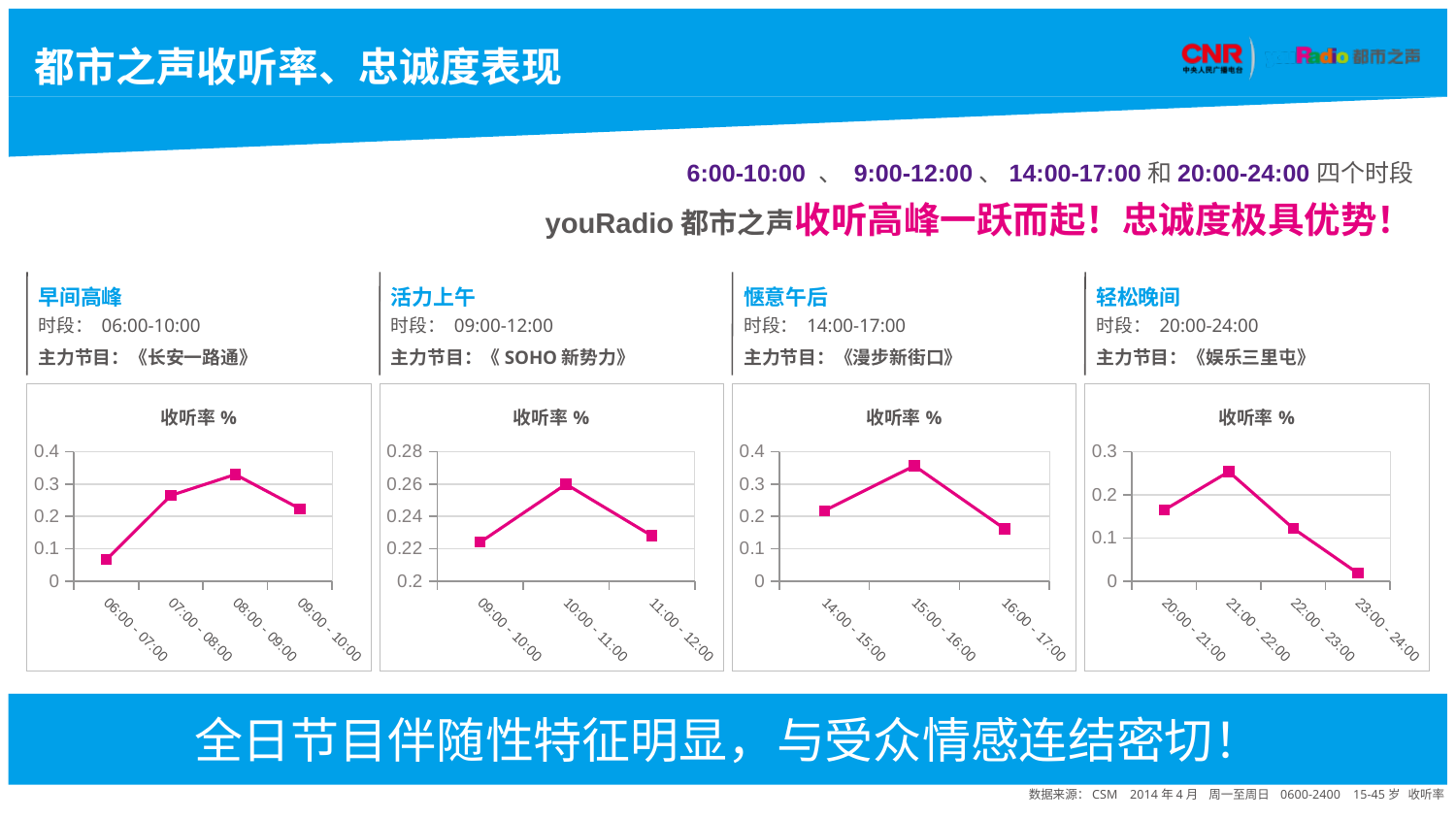
How many time slots are plotted in the 活力上午 (09:00-12:00) chart? 3 In the 活力上午 (09:00-12:00) chart, is the value for 10:00 - 11:00 greater or less than 0.24? greater In the 惬意午后 (14:00-17:00) chart, which time slot has the lowest 收听率? 16:00 - 17:00 In the 轻松晚间 (20:00-24:00) chart, which is larger, the value for 20:00 - 21:00 or the value for 23:00 - 24:00? 20:00 - 21:00 In the 活力上午 (09:00-12:00) chart, which time slot has the highest 收听率? 10:00 - 11:00 What kind of chart is used in the 早间高峰 (06:00-10:00) panel? line chart In the 早间高峰 (06:00-10:00) chart, which time slot has the lowest 收听率? 06:00 - 07:00 In the 轻松晚间 (20:00-24:00) chart, which time slot has the lowest 收听率? 23:00 - 24:00 How many charts are shown on the slide? 4 In the 惬意午后 (14:00-17:00) chart, is the value for 15:00 - 16:00 greater or less than 0.3? greater In the 早间高峰 (06:00-10:00) chart, which time slot has the highest 收听率? 08:00 - 09:00 In the 早间高峰 (06:00-10:00) chart, is the value for 06:00 - 07:00 greater or less than 0.1? less